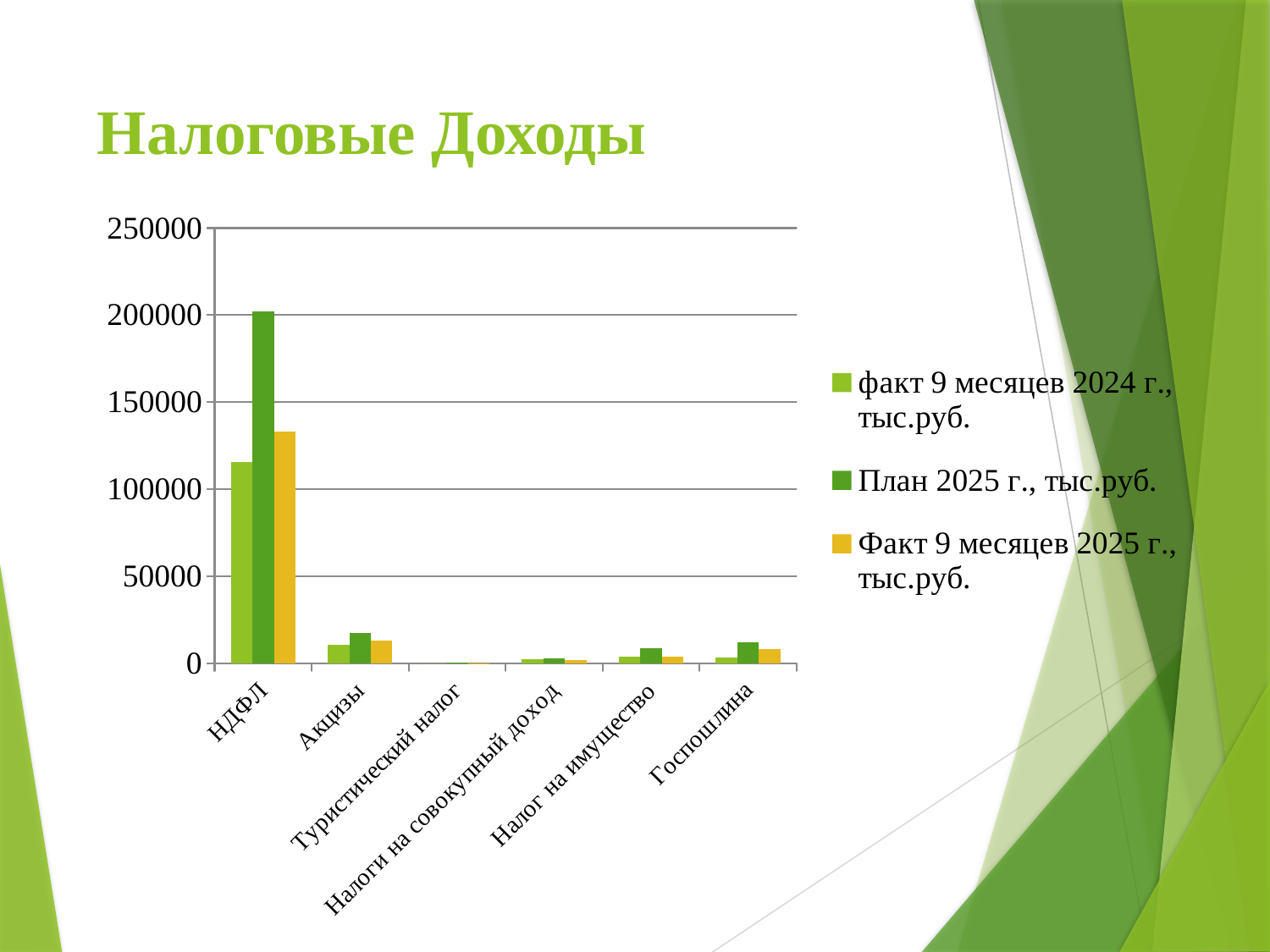
What kind of chart is shown on the slide? bar chart For НДФЛ, which is larger: the value for 'План 2025 г., тыс.руб.' or the value for 'факт 9 месяцев 2024 г., тыс.руб.'? План 2025 г., тыс.руб. Which series is shown in the darkest green colour in the legend? План 2025 г., тыс.руб. Which category has the highest values in the chart? НДФЛ How many categories are shown on the x axis of the chart? 6 How many series does the legend list? 3 Is the value for НДФЛ in the series 'Факт 9 месяцев 2025 г., тыс.руб.' greater or less than 150000? less Is the value for НДФЛ in the series 'факт 9 месяцев 2024 г., тыс.руб.' greater or less than 100000? greater Is the value for Акцизы in the series 'План 2025 г., тыс.руб.' greater or less than 50000? less Which category has the lowest values in the chart? Туристический налог What is the title of the slide containing the chart? Налоговые Доходы For НДФЛ, which is larger: the value for 'Факт 9 месяцев 2025 г., тыс.руб.' or the value for 'факт 9 месяцев 2024 г., тыс.руб.'? Факт 9 месяцев 2025 г., тыс.руб.